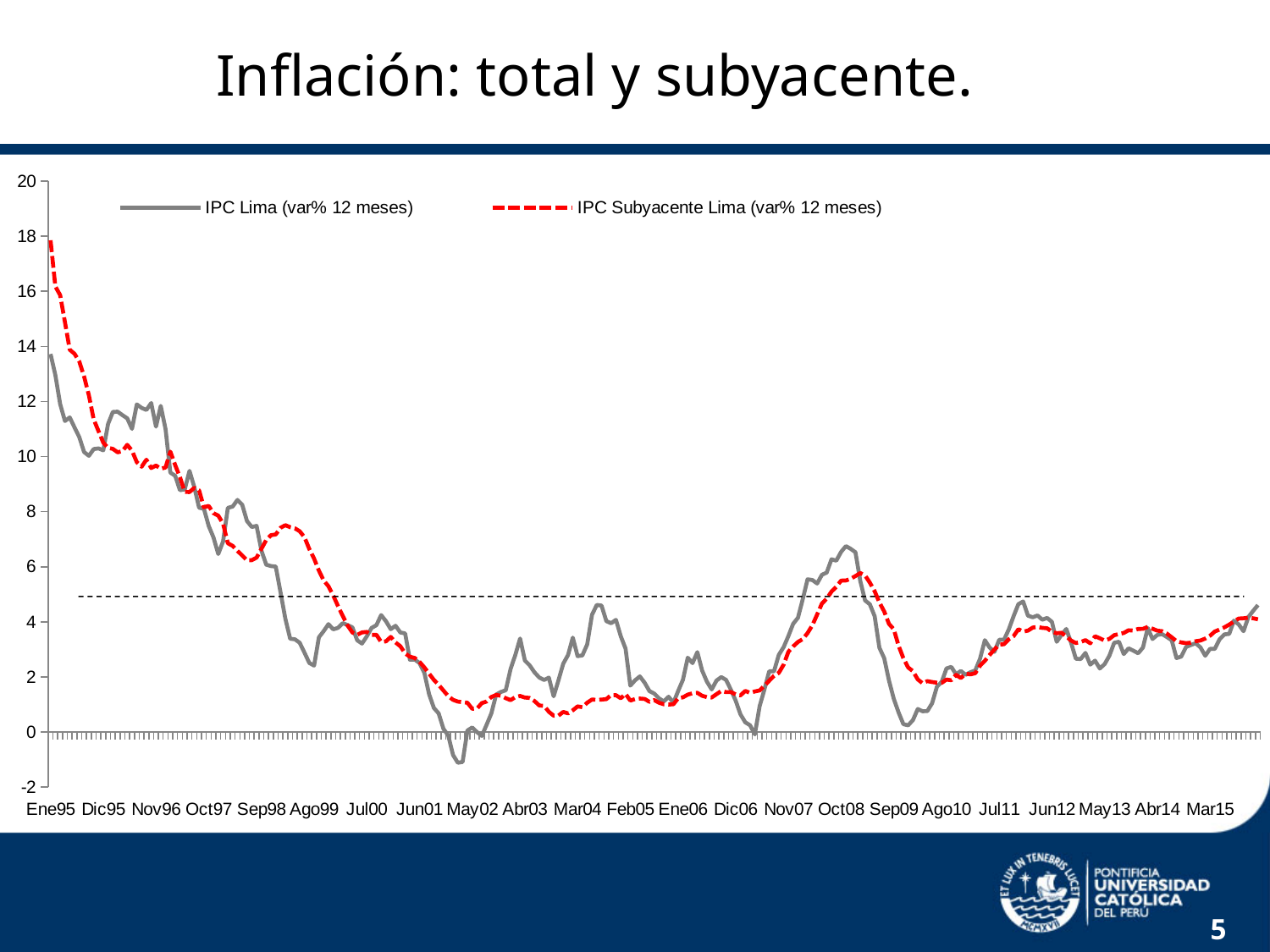
Is the value of IPC Lima (var% 12 meses) at Ene95 greater or less than 12? greater Which series reaches the highest value anywhere on the chart? IPC Subyacente Lima (var% 12 meses) At Ene95, which series has the higher value, IPC Lima or IPC Subyacente Lima? IPC Subyacente Lima (var% 12 meses) Is the value of IPC Lima (var% 12 meses) at Mar15 greater or less than 6? less How many series does the legend list? 2 Is the value of IPC Subyacente Lima (var% 12 meses) at Ene95 greater or less than 16? greater Which series is drawn as a red dashed line? IPC Subyacente Lima (var% 12 meses) What is the title of the slide? Inflación: total y subyacente. What kind of chart is shown on the slide? Line chart Do the values of IPC Subyacente Lima (var% 12 meses) rise or fall from Ene95 to Jul00? fall Which series reaches the lowest value anywhere on the chart? IPC Lima (var% 12 meses)